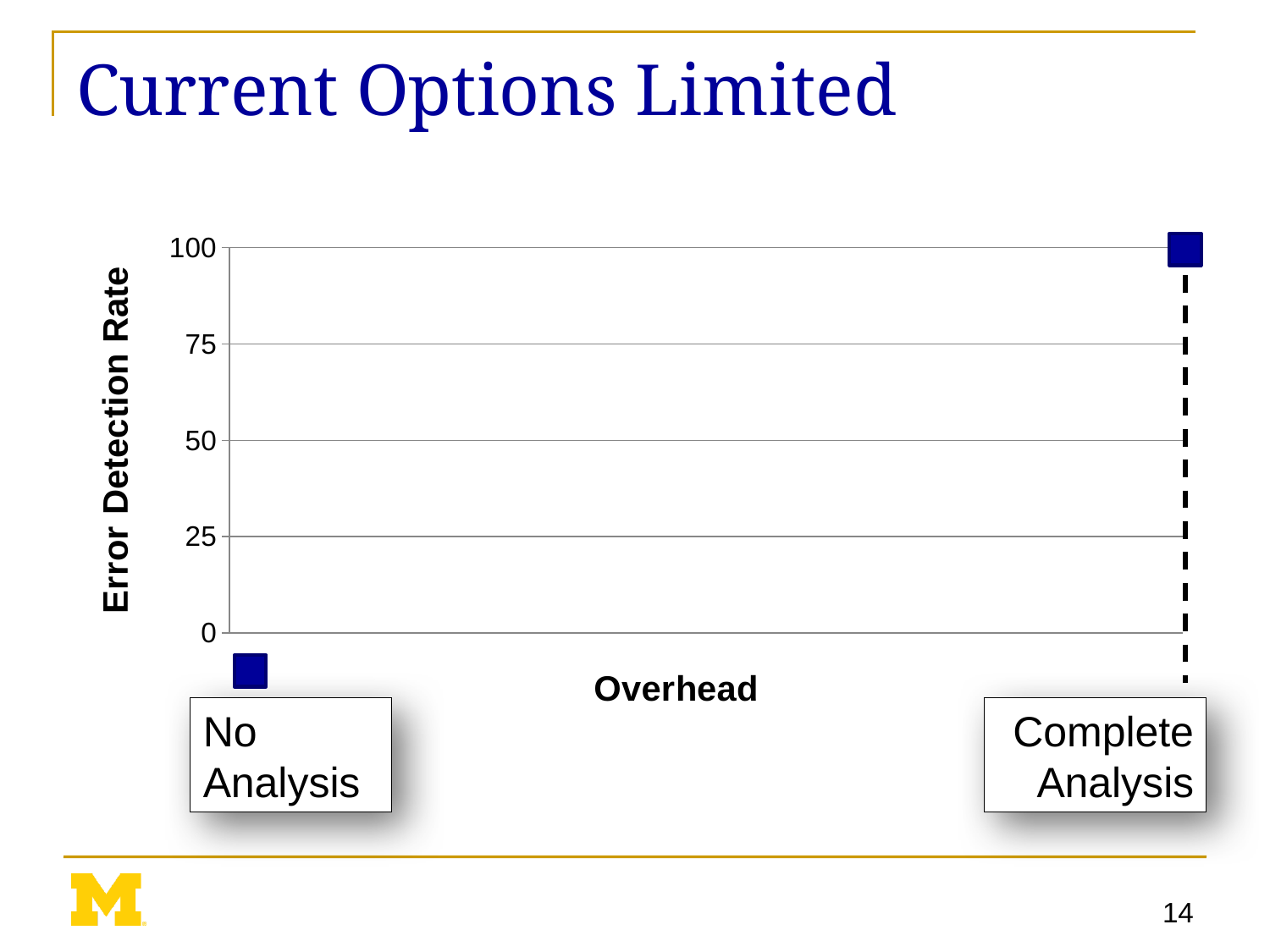
Is the Error Detection Rate for Complete Analysis greater or less than 75? greater What kind of chart is shown on the slide? scatter chart What is the label of the vertical axis? Error Detection Rate Which has a higher Error Detection Rate, No Analysis or Complete Analysis? Complete Analysis Which point has the highest Error Detection Rate? Complete Analysis What is the Error Detection Rate for Complete Analysis? 100 How many data points are plotted on the chart? 2 Is the Error Detection Rate for No Analysis greater or less than 25? less What is the label of the horizontal axis? Overhead Which point has the lowest Error Detection Rate? No Analysis Does the Error Detection Rate rise or fall as Overhead increases along the x axis? rise